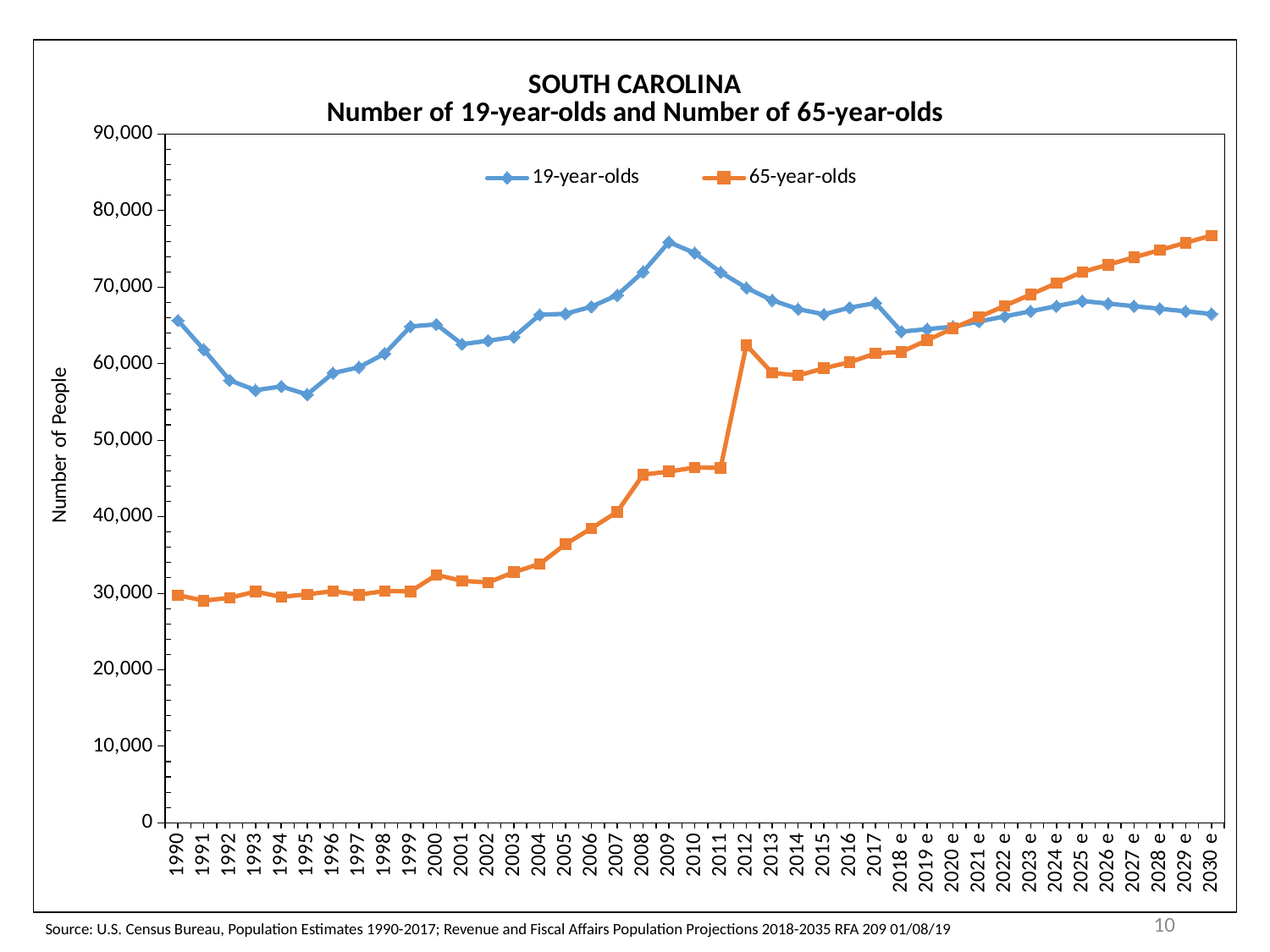
In 2000, which series has the larger value, 19-year-olds or 65-year-olds? 19-year-olds Is the value for 65-year-olds in 1990 greater or less than 40,000? less Is the value for 65-year-olds in 2012 greater or less than 60,000? greater In which year does the 65-year-olds series reach its highest value? 2030 e What kind of chart is shown on the slide? line chart Does the 65-year-olds series generally rise or fall from 1990 to 2030 e? rise What is the label on the y axis? Number of People Is the value for 19-year-olds in 2009 greater or less than 70,000? greater How many series does the legend list? 2 How many years are plotted along the x axis? 41 In which year does the 19-year-olds series reach its highest value? 2009 In 2030 e, which series has the larger value, 19-year-olds or 65-year-olds? 65-year-olds